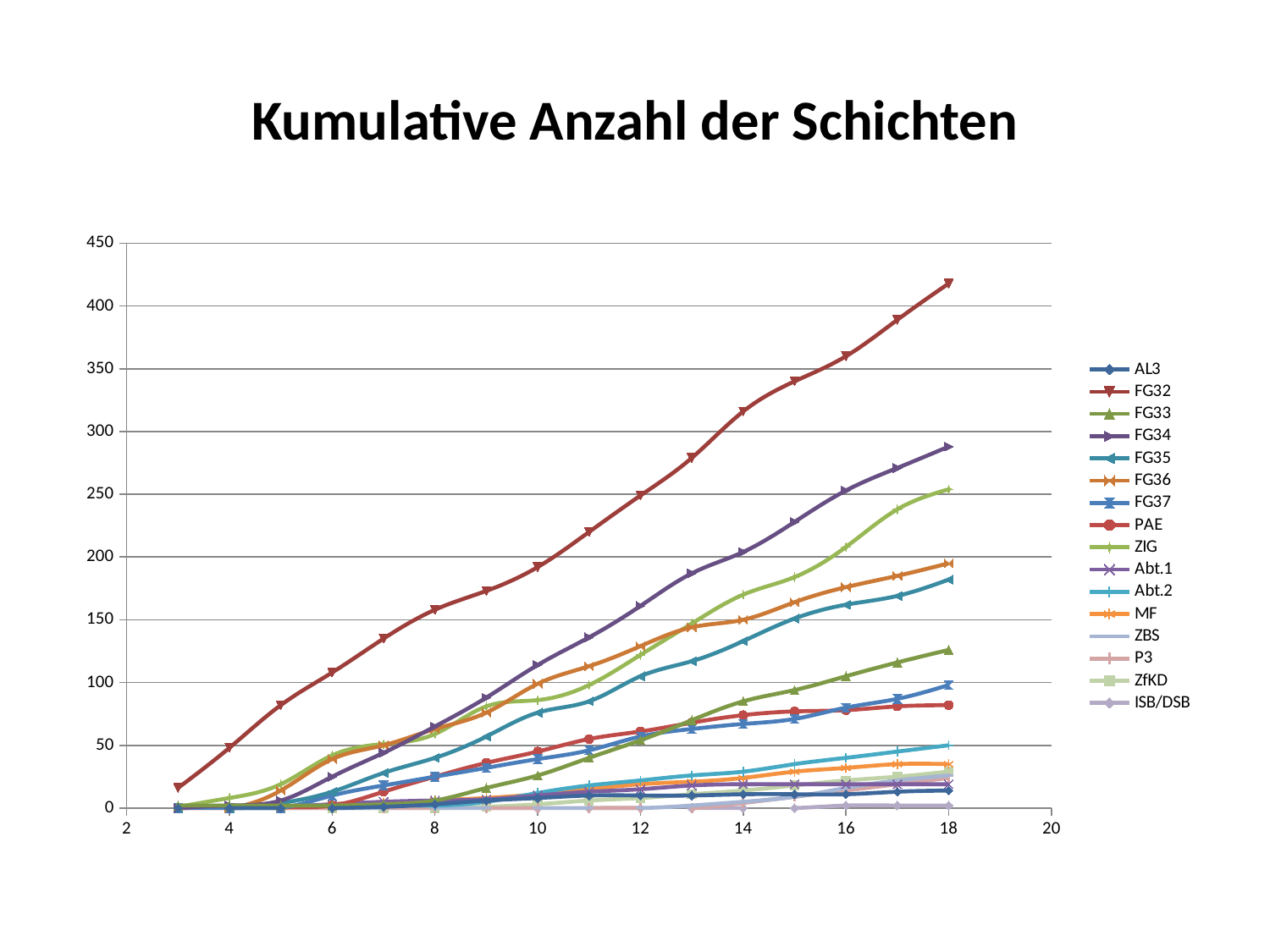
Is the value for FG33 at x = 18 greater or less than 100? greater How many series does the legend list? 16 Which series has the larger value at x = 18, FG34 or FG33? FG34 Which series reaches the highest value at x = 18? FG32 Do the values for FG32 rise or fall as x increases? rise Is the value for FG32 at x = 18 greater or less than 400? greater Is the value for ZIG at x = 18 greater or less than 200? greater What kind of chart is shown on the slide? line chart What is the title of the chart? Kumulative Anzahl der Schichten